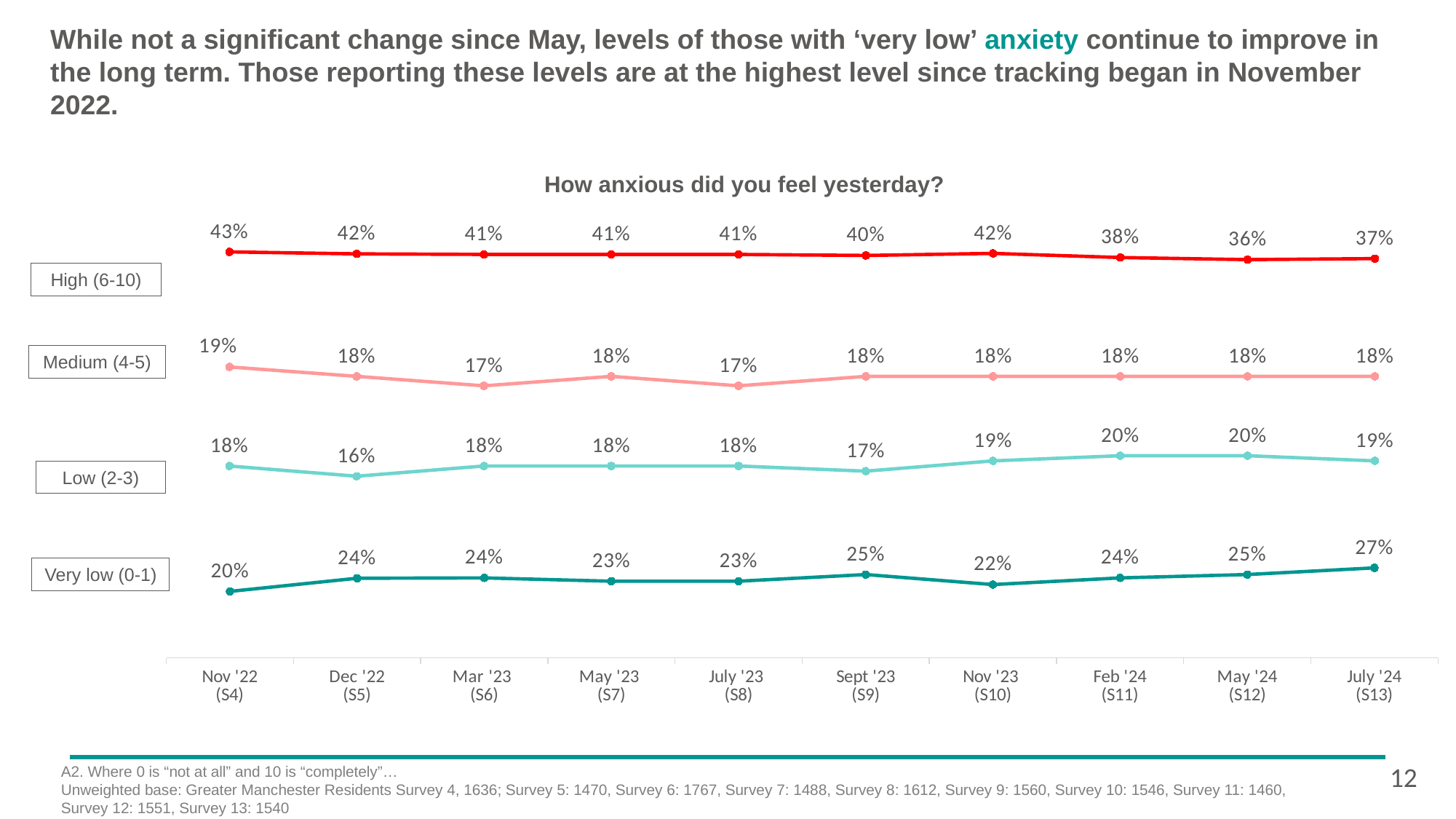
In which survey wave is the Very low (0-1) value highest? July '24 (S13) What is the value for High (6-10) in Nov '22 (S4)? 43% What is the value for Very low (0-1) in July '24 (S13)? 27% What is the value for Low (2-3) in Dec '22 (S5)? 16% How many series are plotted on the chart? 4 What is the value for Medium (4-5) in Mar '23 (S6)? 17% Which is larger in Nov '23 (S10): the Low (2-3) value or the Very low (0-1) value? Very low (0-1) What is the difference between the High (6-10) value in Nov '22 (S4) and in July '24 (S13)? 6 percentage points What is the title of the chart? How anxious did you feel yesterday? What kind of chart is shown? Line chart How many survey waves are shown on the x axis? 10 In which survey wave is the High (6-10) value lowest? May '24 (S12)